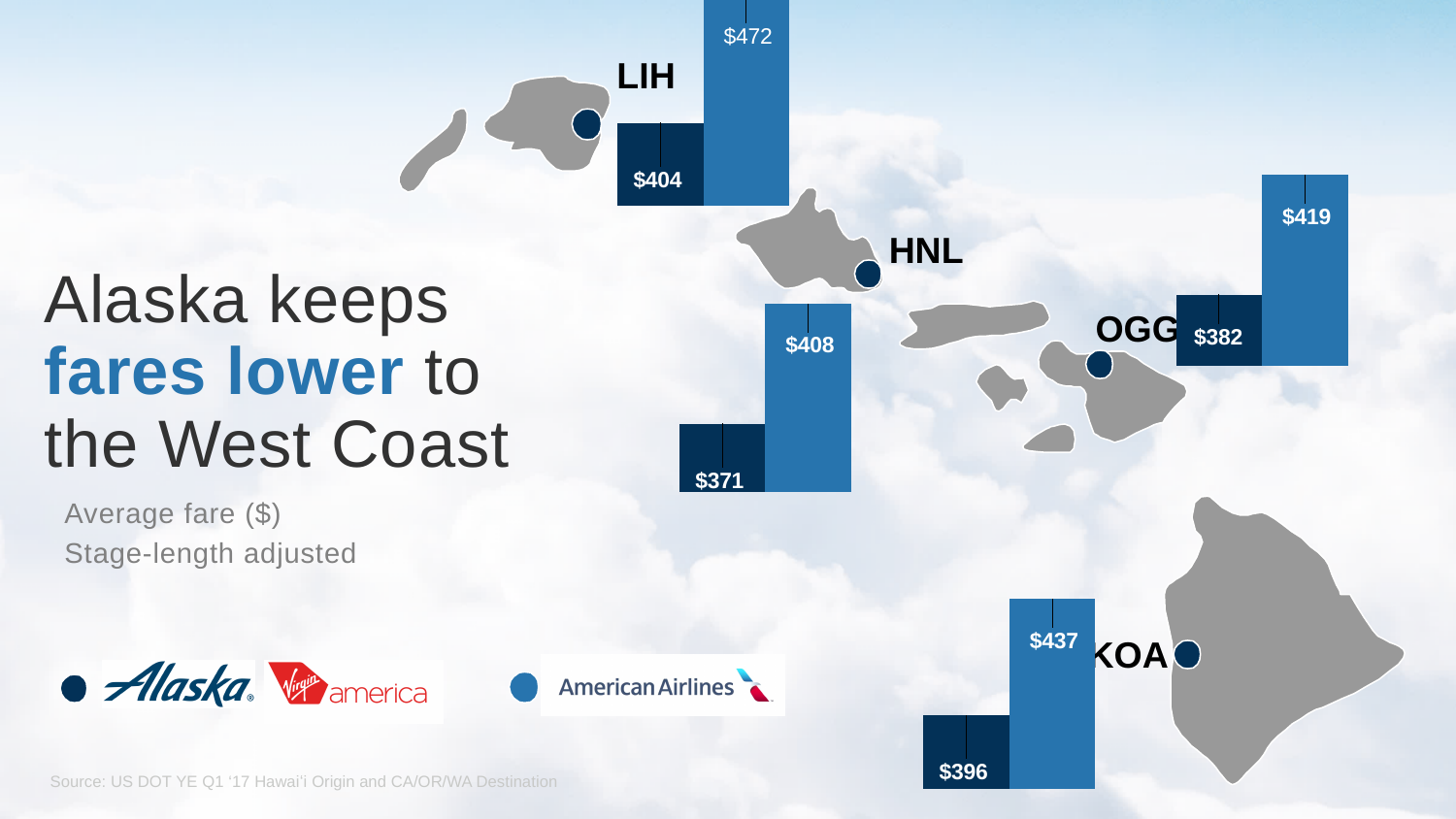
In the LIH chart, what is the difference between the American Airlines fare and the Alaska/Virgin America fare? $68 In the OGG chart, what is the average fare for American Airlines? $419 In the OGG chart, which airline has the lower average fare? Alaska/Virgin America In the HNL chart, what is the average fare for Alaska/Virgin America? $371 In the KOA chart, what is the average fare for Alaska/Virgin America? $396 In the LIH chart, what is the average fare for Alaska/Virgin America? $404 What kind of chart is used for each airport on the slide? Bar chart Across the four airport charts, which airport has the highest American Airlines fare? LIH In the KOA chart, which airline has the higher average fare? American Airlines In the LIH chart, what is the average fare for American Airlines? $472 How many airport charts are shown on the slide? 4 In the HNL chart, what is the difference between the American Airlines fare and the Alaska/Virgin America fare? $37